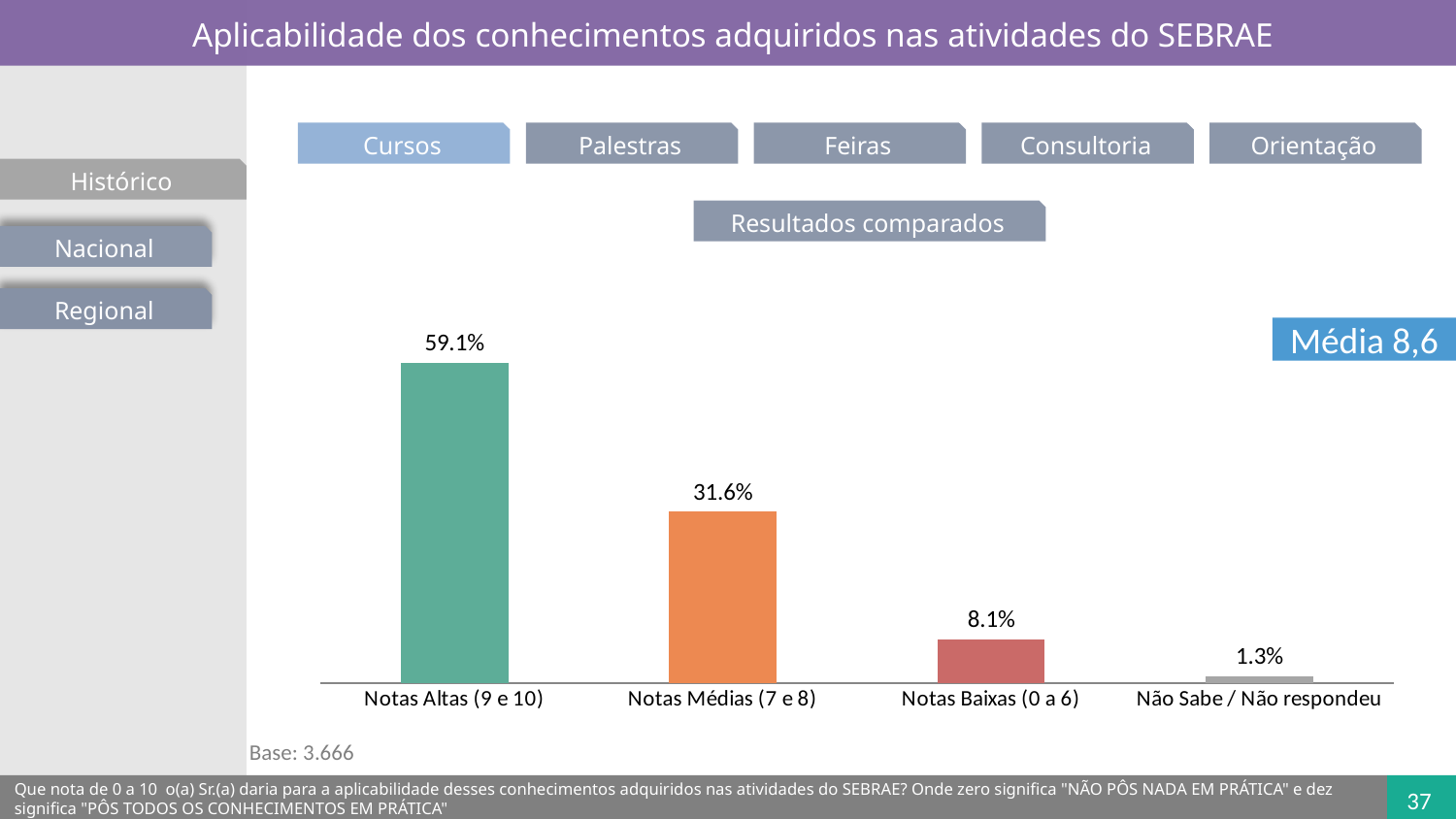
What is the value for Notas Médias (7 e 8)? 31.6% What average (Média) is shown on the slide? 8,6 What is the value for Não Sabe / Não respondeu? 1.3% Which is larger, the value for Notas Baixas (0 a 6) or Não Sabe / Não respondeu? Notas Baixas (0 a 6) Do the values rise or fall from left to right along the x axis? Fall What is the value for Notas Baixas (0 a 6)? 8.1% What kind of chart is shown on the slide? Bar chart What is the value for Notas Altas (9 e 10)? 59.1% How many categories are shown in the chart? 4 Which category has the highest value? Notas Altas (9 e 10) What is the difference between the values for Notas Altas (9 e 10) and Notas Médias (7 e 8)? 27.5% Which category has the lowest value? Não Sabe / Não respondeu